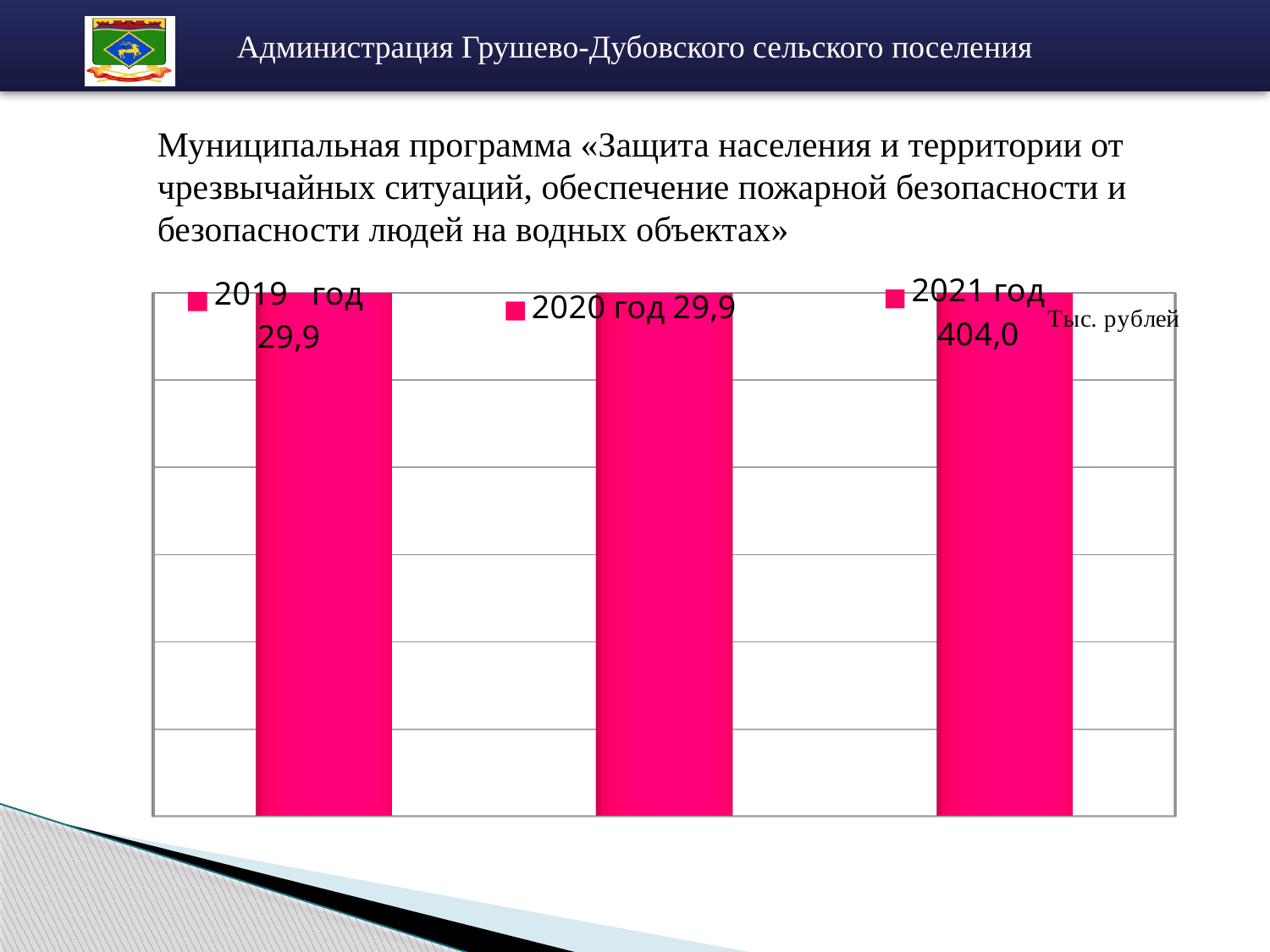
What value is shown for 2019 год? 29,9 What value is shown for 2020 год? 29,9 What unit is indicated for the chart values? Тыс. рублей What colour are the bars on the chart? pink What value is shown for 2021 год? 404,0 How many bars are plotted on the chart? 3 Which labelled value is larger, 2021 год or 2020 год? 2021 год What is the difference between the labelled values for 2021 год and 2019 год? 374,1 Which year has the highest labelled value? 2021 год What kind of chart is shown on the slide? bar chart